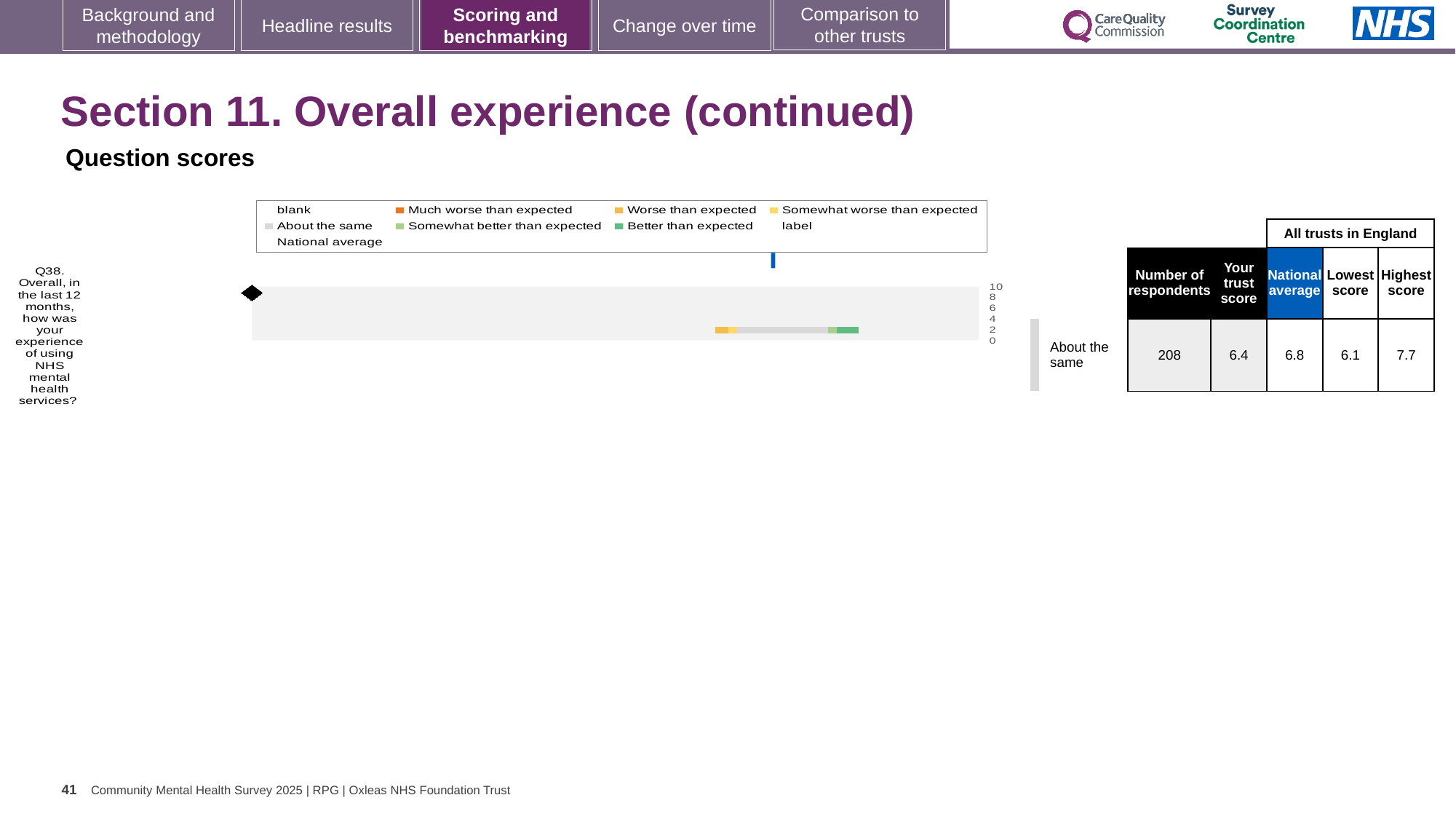
What is the highest score among all trusts in England for Q38? 7.7 What is the difference between the national average and the trust score for Q38? 0.4 How many respondents answered Q38? 208 What kind of chart is shown on the slide? Bar chart How many questions are plotted on the chart? 1 What is the national average score shown for Q38? 6.8 What is the lowest score among all trusts in England for Q38? 6.1 What is the difference between the highest and lowest scores among all trusts in England for Q38? 1.6 How does the trust's score for Q38 compare with other trusts, according to the benchmark label? About the same Which is larger for Q38, the trust score or the national average? National average Is the trust score for Q38 greater or less than 8? less What is the trust score for Q38 (Overall, in the last 12 months, how was your experience of using NHS mental health services?)? 6.4